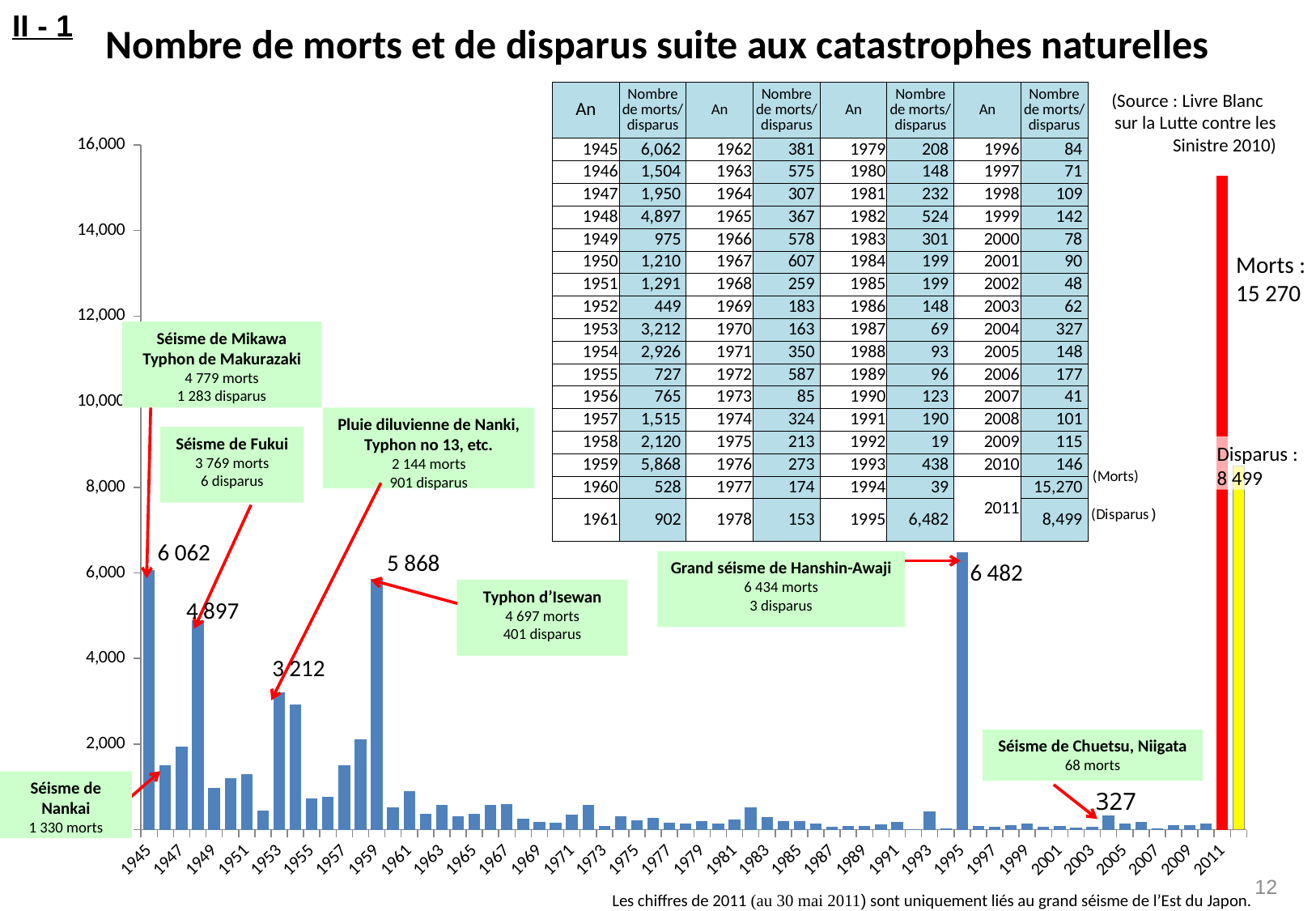
What kind of chart is shown on the slide? bar chart What is the title of the chart on the slide? Nombre de morts et de disparus suite aux catastrophes naturelles What value is labelled on the bar for 1995? 6 482 What colour is the bar representing 'Morts' for 2011? red What is the number of 'Disparus' shown for 2011 on the yellow bar? 8 499 What value is labelled on the bar for 1945? 6 062 Is the value for 1949 greater or less than 2,000? less Which year has the larger labelled value, 1945 or 1995? 1995 What value is labelled on the bar for 2004? 327 What is the difference between the labelled values for 1945 and 1948? 1 165 What is the number of 'Morts' shown for 2011 on the red bar? 15 270 What value is labelled on the bar for 1959? 5 868